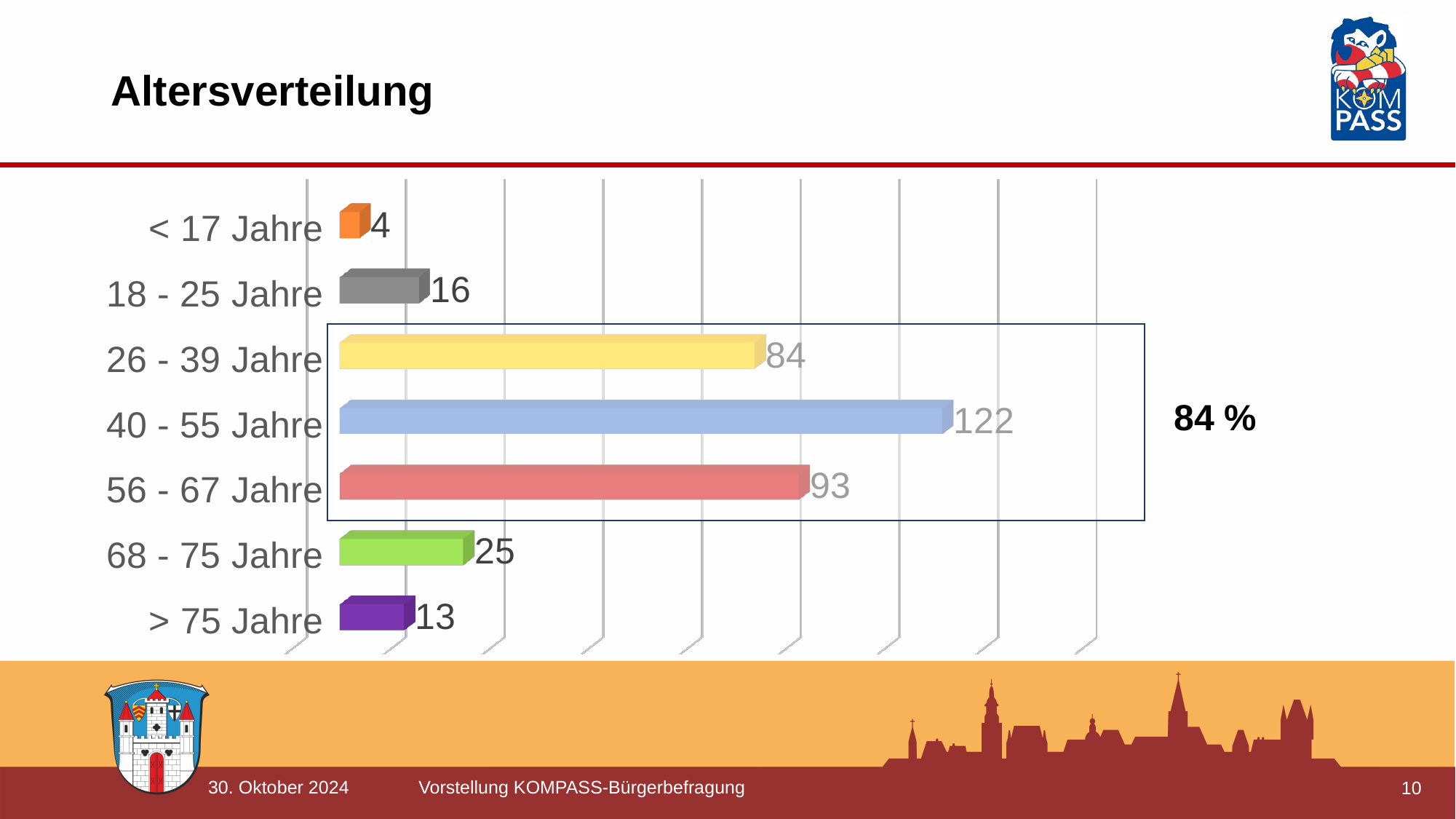
What is the difference between the values for 26 - 39 Jahre and 18 - 25 Jahre? 68 Which age category has the lowest value? < 17 Jahre What is the value for the 68 - 75 Jahre category? 25 Which age category has the highest value? 40 - 55 Jahre What kind of chart is shown on the slide? bar chart What percentage is shown next to the box enclosing the 26 - 39, 40 - 55 and 56 - 67 Jahre bars? 84 % What is the value for the 40 - 55 Jahre category? 122 What is the difference between the values for 40 - 55 Jahre and 56 - 67 Jahre? 29 What is the value for the < 17 Jahre category? 4 Which is larger, the value for 68 - 75 Jahre or the value for > 75 Jahre? 68 - 75 Jahre How many age categories are shown in the chart? 7 What is the title of the slide containing the chart? Altersverteilung